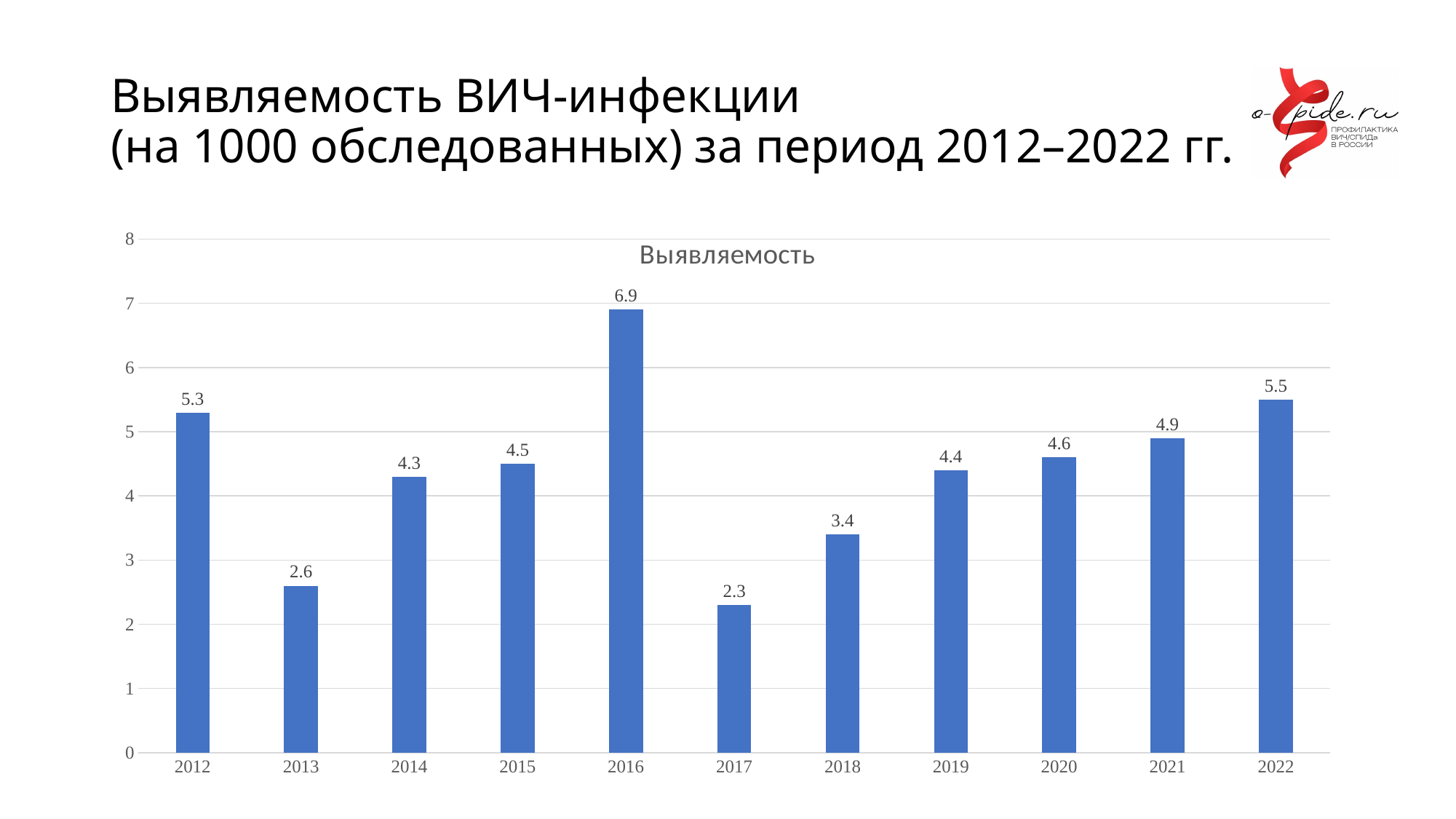
How many years are shown on the x axis? 11 What is the value for 2016? 6.9 What kind of chart is this? bar chart Which year has the highest value? 2016 What is the difference between the values for 2016 and 2017? 4.6 What is the title shown inside the chart area? Выявляемость Is the value for 2018 greater or less than 4? less What is the difference between the values for 2022 and 2021? 0.6 What is the value for 2022? 5.5 What is the value for 2013? 2.6 Which is larger, the value for 2012 or the value for 2015? 2012 Which year has the lowest value? 2017